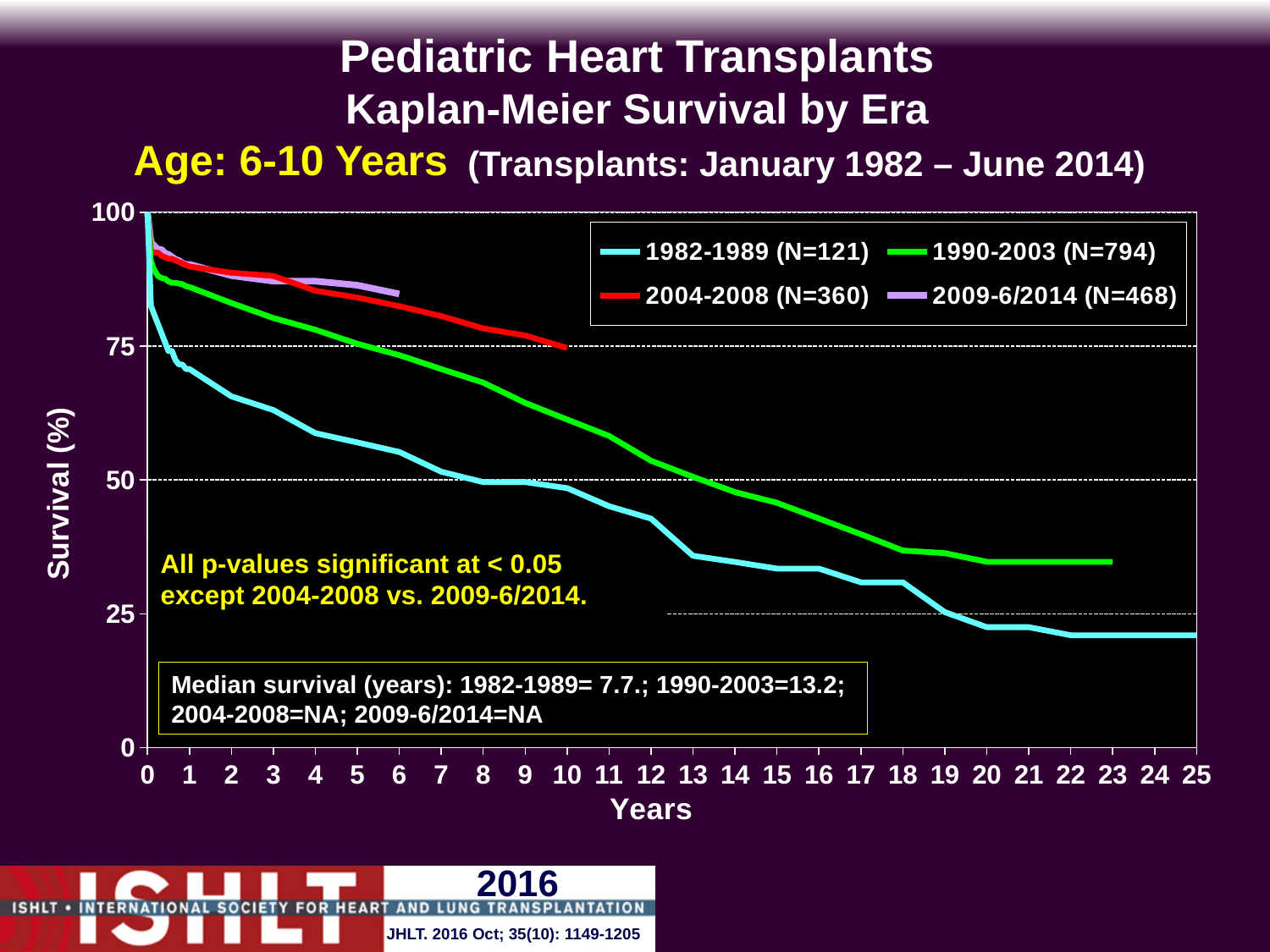
What is the median survival in years for the 1990-2003 era? 13.2 Do the survival curves rise or fall as years increase? fall Is the survival value for the 1982-1989 era at 25 years greater or less than 25? less What is the N for the 2009-6/2014 era shown in the legend? 468 What is the median survival in years for the 1982-1989 era? 7.7 What is the N for the 1990-2003 era shown in the legend? 794 Which era has the lowest survival curve across the chart? 1982-1989 Is the survival value for the 2009-6/2014 era at 6 years greater or less than 75? greater What kind of chart is shown on the slide? line chart At 10 years, which era has higher survival: 1990-2003 or 1982-1989? 1990-2003 How many series (eras) does the legend list? 4 What is the label of the x axis? Years